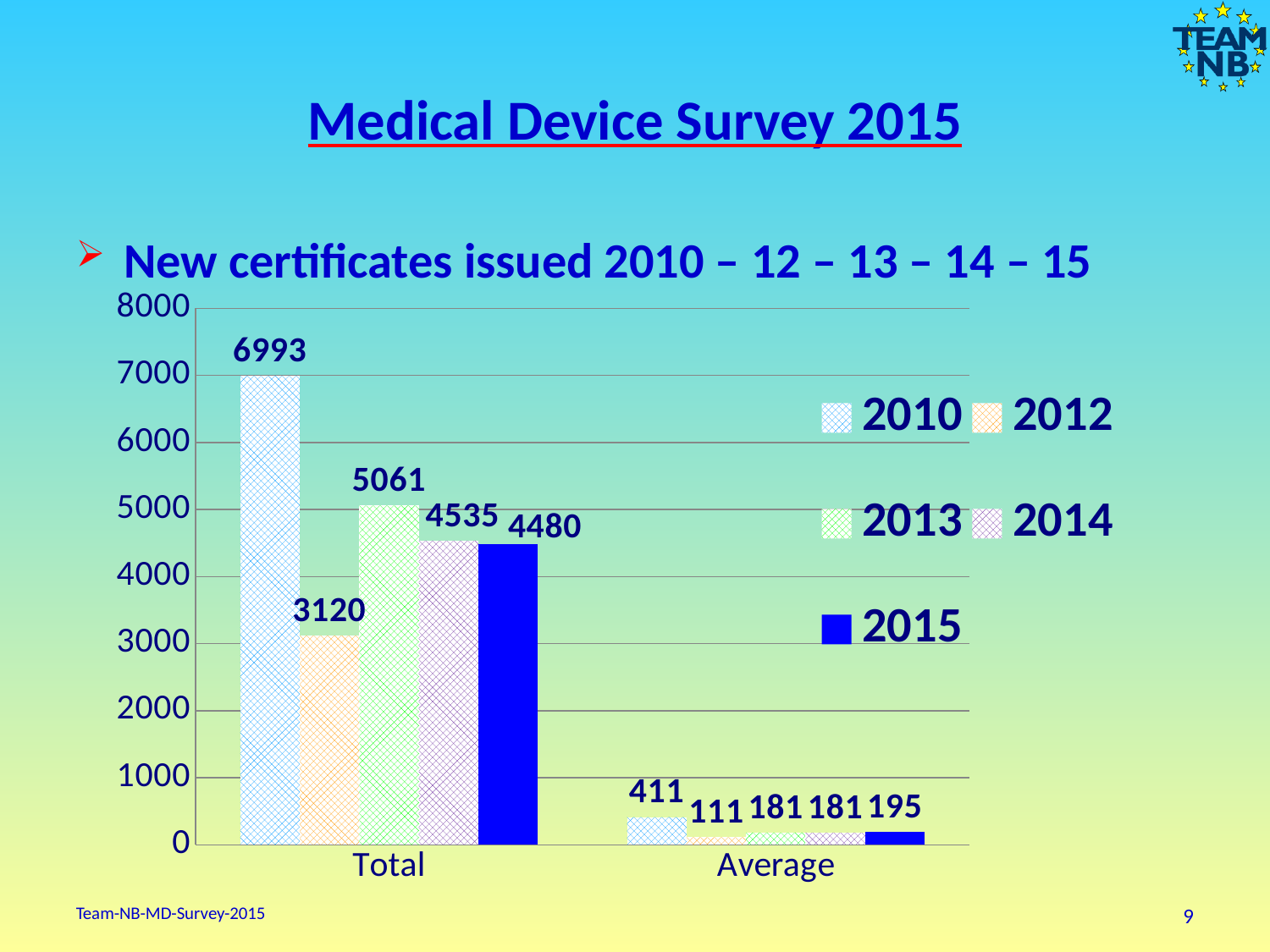
Which year has the highest Total value? 2010 What is the Average value for 2015? 195 What kind of chart is shown? bar chart Which series is shown with a solid blue bar? 2015 What is the difference between the Total values for 2013 and 2014? 526 Which is larger, the Total value for 2014 or for 2015? 2014 Which year has the lowest Average value? 2012 How many categories are shown on the x axis? 2 What is the Total value for 2010? 6993 What is the Total value for 2012? 3120 How many series does the legend list? 5 What is the difference between the Average values for 2010 and 2012? 300